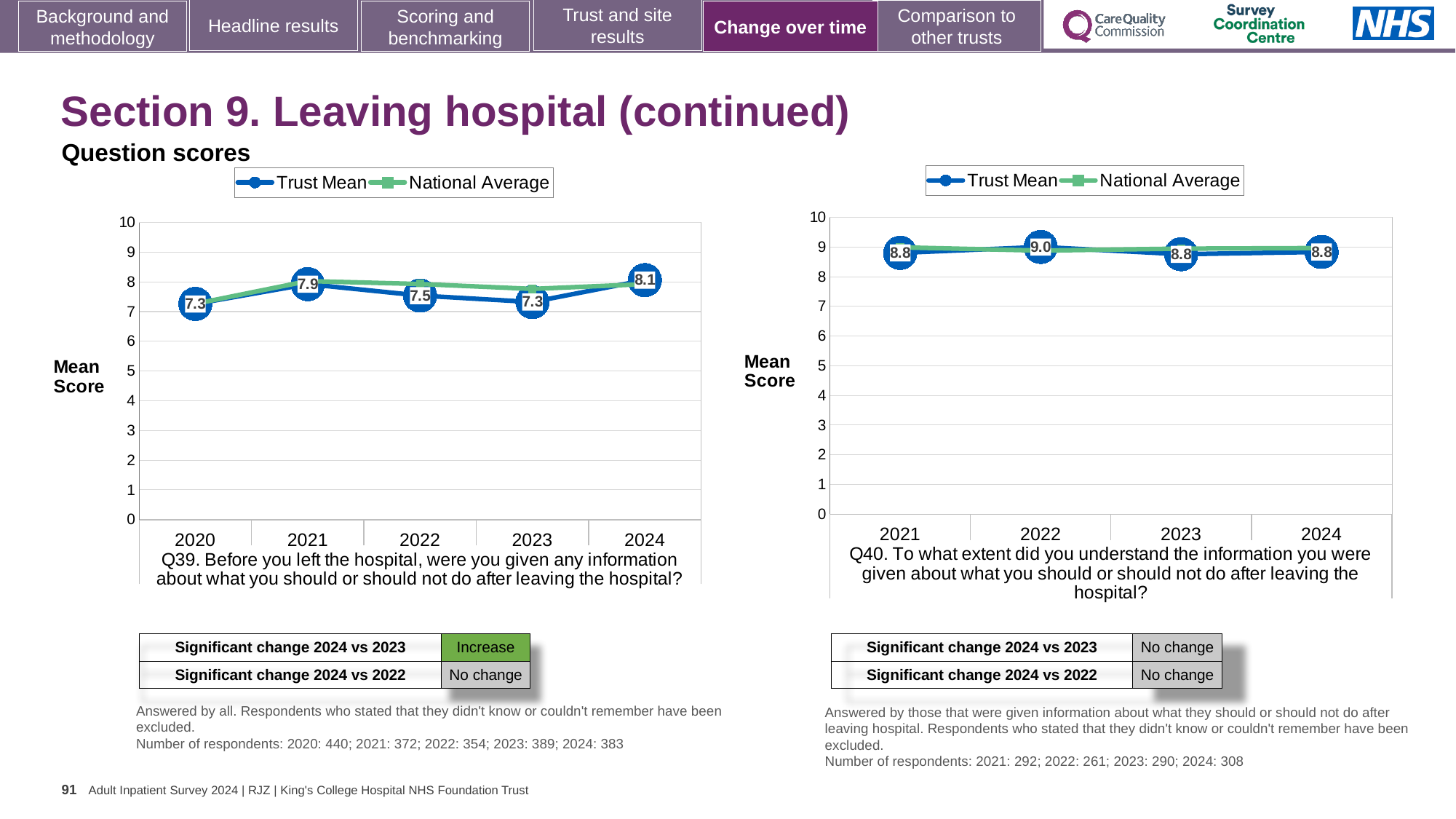
In the Q39 chart (left), what colour is the Trust Mean line? blue In the Q40 chart (right), is the National Average for 2023 greater or less than 8? greater In the Q39 chart (left), how many years are shown on the x axis? 5 In the Q39 chart (left), is the Trust Mean score for 2021 higher or lower than for 2022? higher In the Q40 chart (right), which year has the highest Trust Mean score? 2022 In the Q39 chart (left), what is the Trust Mean score for 2020? 7.3 In the Q39 chart (left), which year has the highest Trust Mean score? 2024 What type of chart is used for Q39 (left)? line chart In the Q40 chart (right), what is the Trust Mean score for 2022? 9.0 In the Q39 chart (left), what is the Trust Mean score for 2024? 8.1 In the Q39 chart (left), what is the difference between the Trust Mean scores for 2024 and 2023? 0.8 In the Q40 chart (right), how many series does the legend list? 2